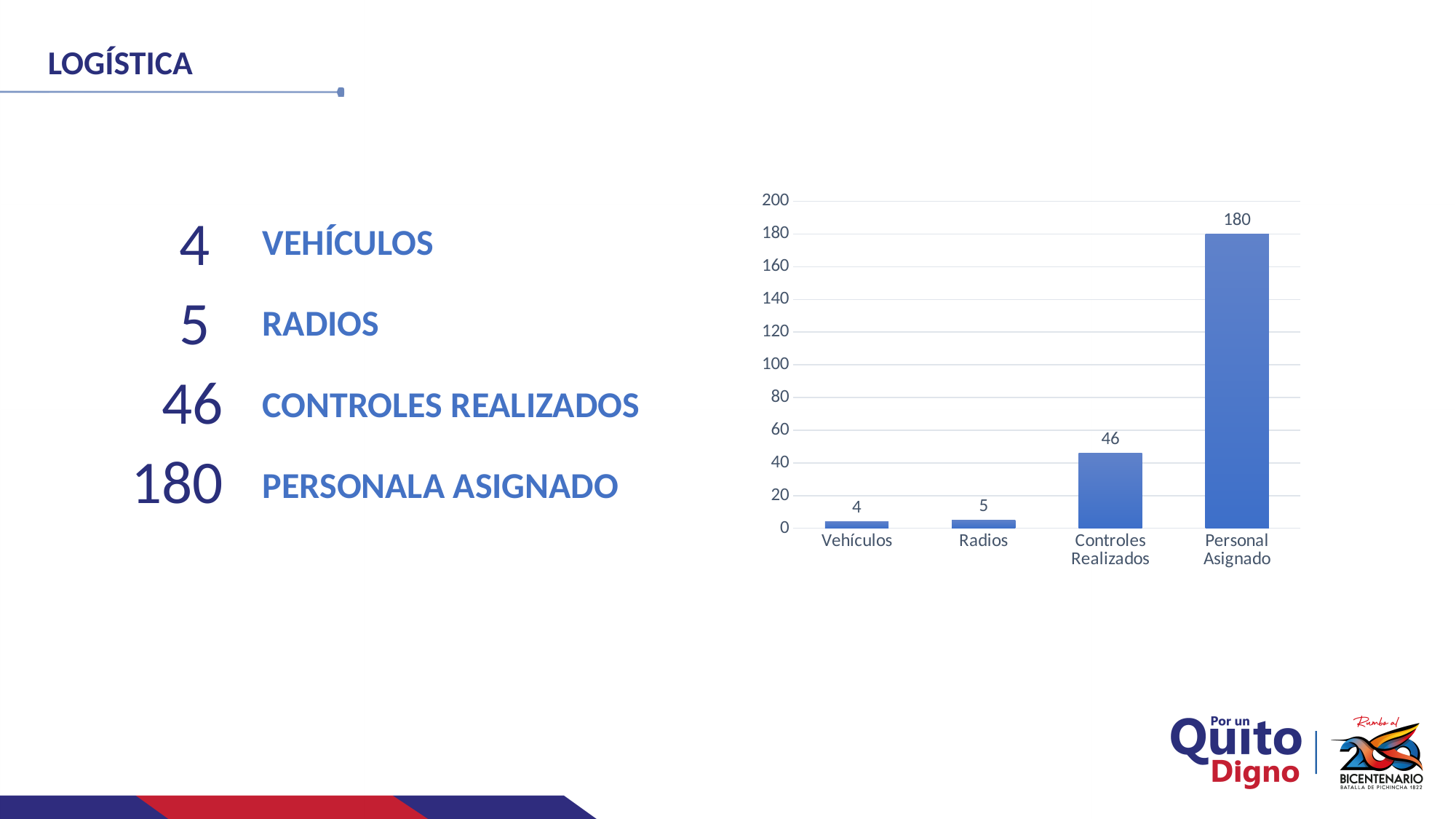
What is the difference between Controles Realizados and Radios? 41 What is the value for Personal Asignado? 180 Which category has the lowest value? Vehículos What is the value for Controles Realizados? 46 What is the value for Radios? 5 What kind of chart is shown on the slide? bar chart What is the difference between Personal Asignado and Controles Realizados? 134 What is the value for Vehículos? 4 How many categories are shown on the x axis? 4 Which is larger, Controles Realizados or Radios? Controles Realizados Is the value for Personal Asignado greater or less than 100? greater Which category has the highest value? Personal Asignado